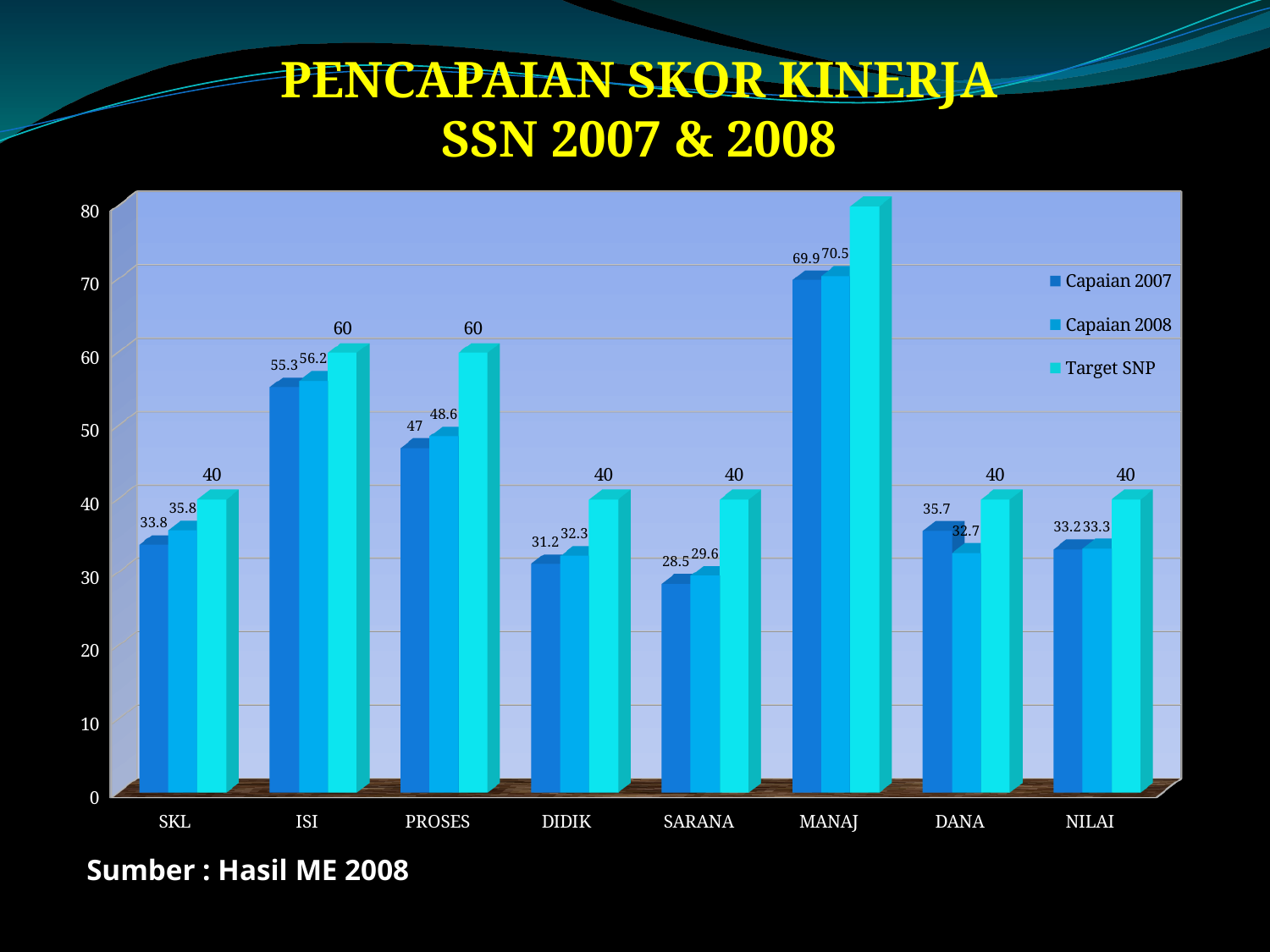
How many series does the legend list? 3 Which category has the lowest Capaian 2007 value? SARANA What is the Capaian 2007 value for SKL? 33.8 How many categories are shown on the x axis? 8 What is the difference between the Capaian 2008 and Capaian 2007 values for ISI? 0.9 What is the Target SNP value for ISI? 60 What is the source cited below the chart? Hasil ME 2008 What is the Capaian 2008 value for PROSES? 48.6 Which is larger for DANA: Capaian 2007 or Capaian 2008? Capaian 2007 What kind of chart is shown on the slide? bar chart Which category has the highest Capaian 2008 value? MANAJ Is the Target SNP value for MANAJ greater or less than 70? greater